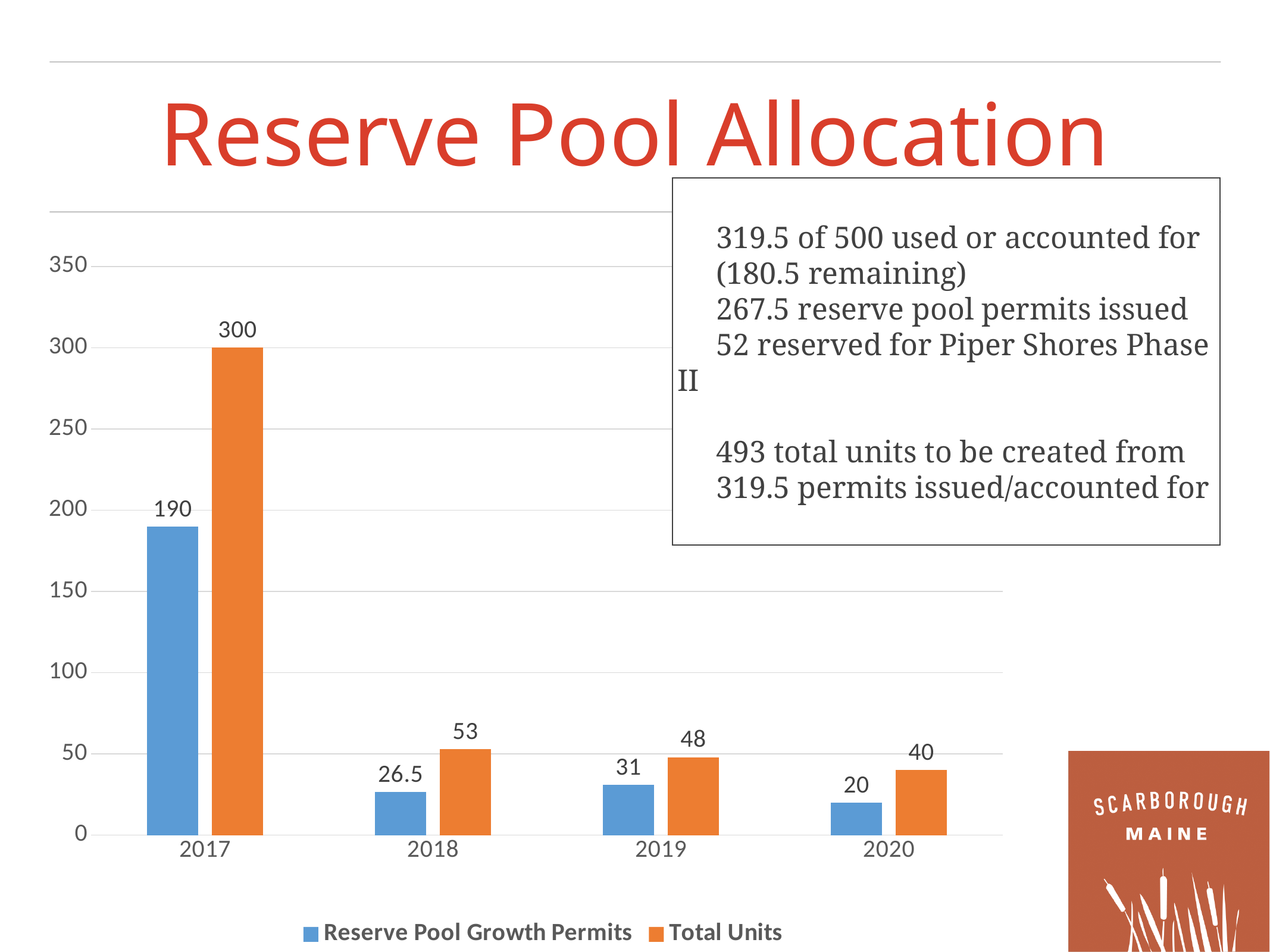
What is the difference between Total Units and Reserve Pool Growth Permits in 2019? 17 Which year has the lowest Reserve Pool Growth Permits value? 2020 What kind of chart is shown on the slide? Bar chart What is the value of Total Units for 2018? 53 How many years are shown on the x axis? 4 Which is larger in 2020: Reserve Pool Growth Permits or Total Units? Total Units What is the value of Reserve Pool Growth Permits for 2018? 26.5 What is the value of Total Units for 2020? 40 Do the Total Units values rise or fall from 2018 to 2020? Fall Which year has the highest Total Units value? 2017 What is the value of Reserve Pool Growth Permits for 2017? 190 How many series does the legend list? 2